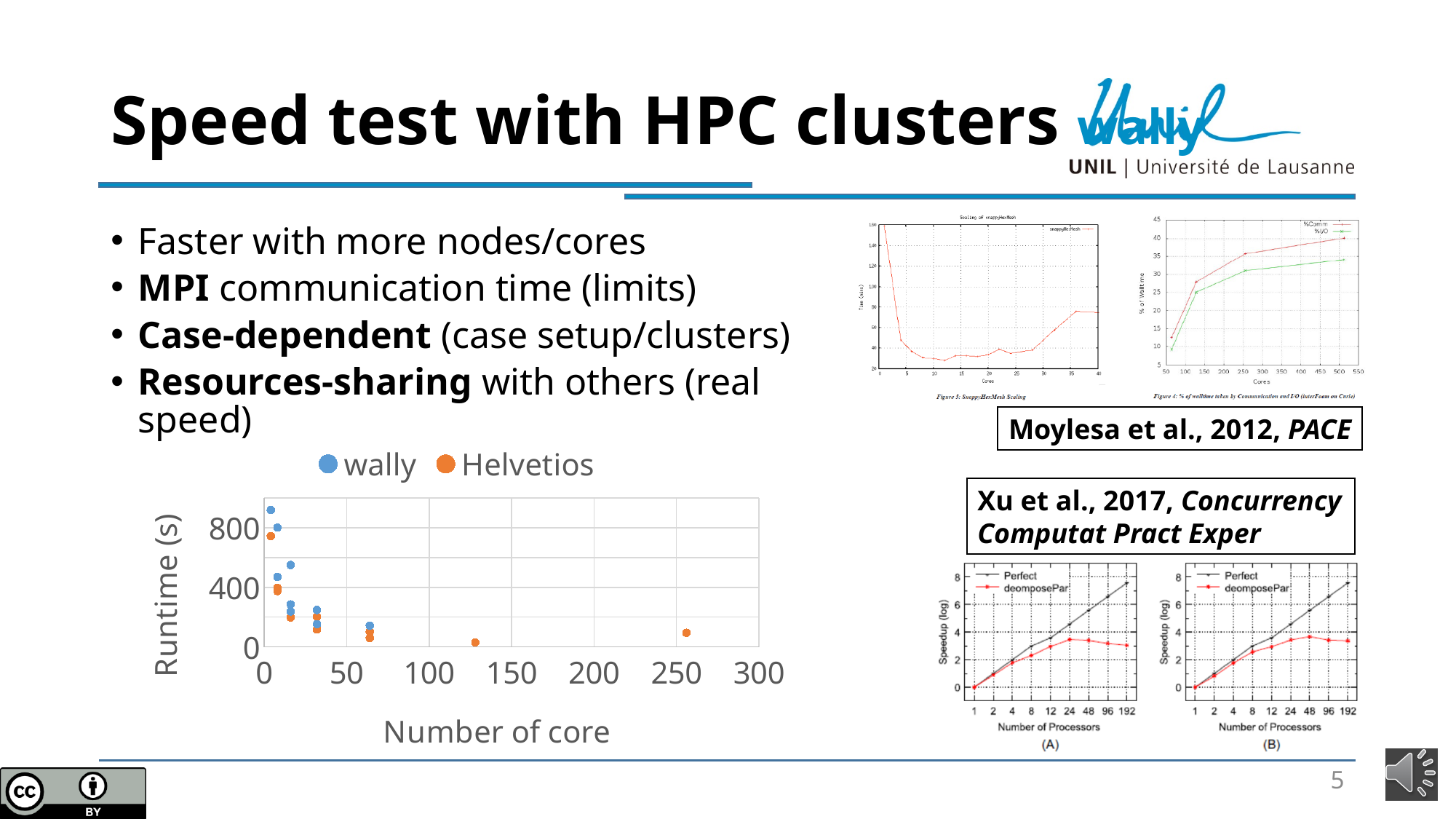
How many series does the legend list in each of the Xu et al., 2017 speedup charts at the bottom right? 2 In the 'Runtime (s)' versus 'Number of core' chart, which series has the highest runtime value plotted? wally In the 'Runtime (s)' versus 'Number of core' chart, is the runtime of the Helvetios point at about 128 cores greater or less than 400? less In the 'Runtime (s)' versus 'Number of core' chart, which colour represents the Helvetios series? orange What kind of chart is the 'Runtime (s)' versus 'Number of core' chart on the left of the slide? scatter chart In the Xu et al., 2017 speedup charts at the bottom right, does the 'Perfect' line rise or fall as the number of processors increases? rise In the 'Runtime (s)' versus 'Number of core' chart, is the highest wally runtime value greater or less than 800? greater In the 'Runtime (s)' versus 'Number of core' chart, what are the two series named in the legend? wally and Helvetios In the 'Runtime (s)' versus 'Number of core' chart, what is the maximum value shown on the x axis? 300 In the 'Runtime (s)' versus 'Number of core' chart, does runtime rise or fall as the number of cores increases? fall In the 'Runtime (s)' versus 'Number of core' chart, is the runtime of the Helvetios point at about 256 cores greater or less than 400? less How many series does the legend of the 'Runtime (s)' versus 'Number of core' chart list? 2